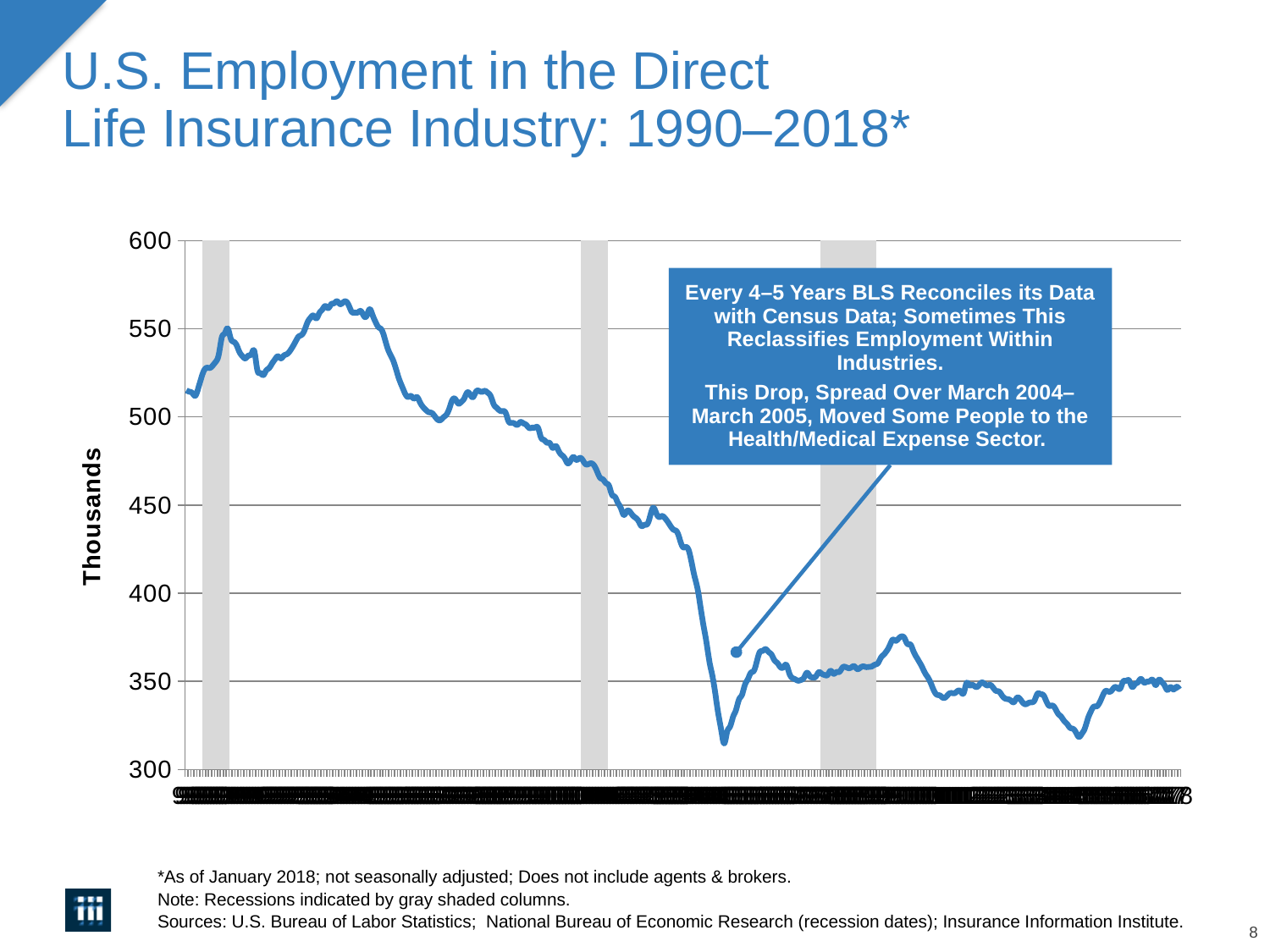
How many gray shaded recession columns are shown on the chart? 3 What kind of chart is shown on the slide? line chart Does the line rise or fall during the sharp drop spread over March 2004 to March 2005? fall Is the value at the end of the series greater or less than 300? greater What is the label on the vertical axis? Thousands Overall, does employment in the direct life insurance industry rise or fall from the start of the series to the end? fall Is the value at the end of the series (January 2018) greater or less than 400? less Is the highest point of the line greater or less than 550? greater